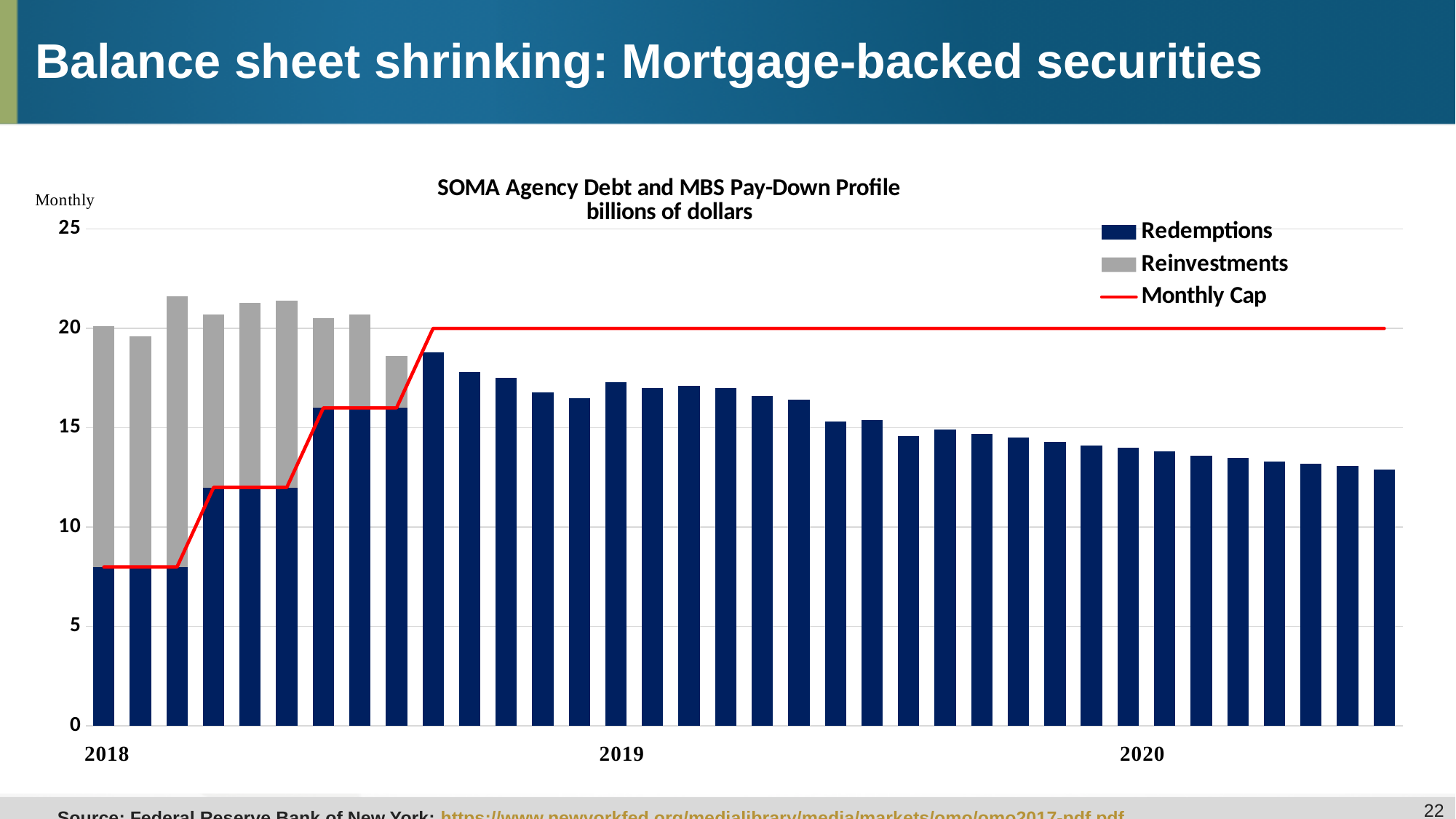
Is the Redemptions value for the first bar in 2018 greater or less than 10? less Is the Redemptions value for the last bar in 2020 greater or less than 15? less How many bars are plotted in the chart? 36 What value does the Monthly Cap line reach and hold from late 2018 through 2020? 20 What are the three series named in the legend? Redemptions, Reinvestments, Monthly Cap How many series does the legend list? 3 What kind of chart is shown on the slide? Bar chart (stacked bars with a line) Does the Monthly Cap line rise or fall during 2018? Rise Which is larger: the Redemptions value for the first bar in 2018 or the Redemptions value for the last bar in 2020? The last bar in 2020 Do the Redemptions values rise or fall across 2019 and 2020? Fall What is the title of the chart? SOMA Agency Debt and MBS Pay-Down Profile billions of dollars Is the total height (Redemptions plus Reinvestments) of the third bar in 2018 greater or less than 20? greater